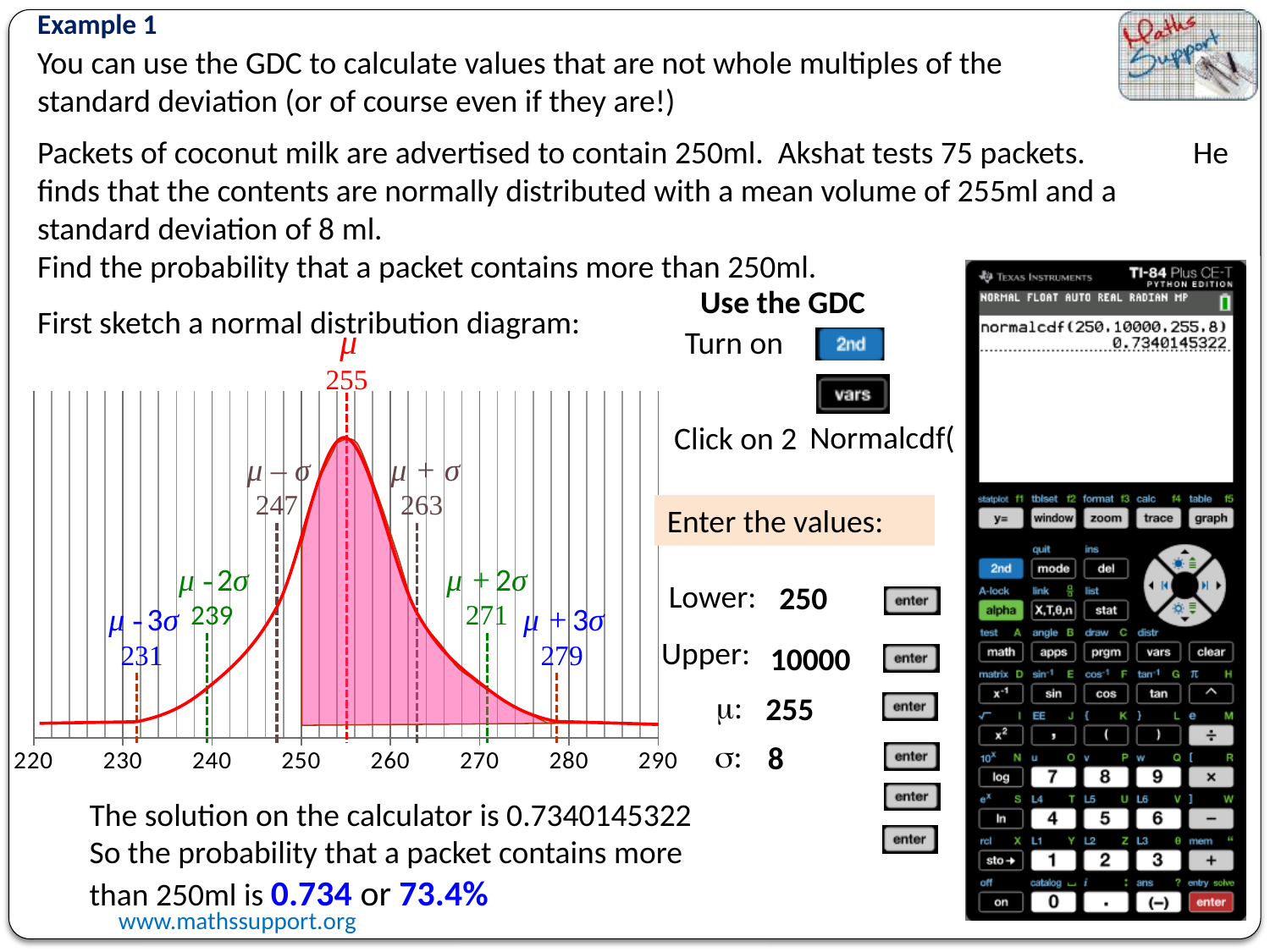
What is the lowest value shown on the x axis of the normal distribution diagram? 220 What is the highest value shown on the x axis of the normal distribution diagram? 290 What value is labelled at μ − σ on the normal distribution diagram? 247 What value is labelled at μ + σ on the normal distribution diagram? 263 What value is labelled at the mean μ on the normal distribution diagram? 255 What is the difference between the values labelled at μ + σ and μ − σ on the diagram? 16 What value is labelled at μ + 3σ on the normal distribution diagram? 279 At what x-axis value does the shaded region under the curve begin? 250 What value is labelled at μ + 2σ on the normal distribution diagram? 271 Which is larger on the diagram, the value labelled at μ − 2σ or the value labelled at μ − σ? μ − σ What is the difference between the values labelled at μ + 3σ and μ − 3σ on the diagram? 48 What value is labelled at μ − 3σ on the normal distribution diagram? 231